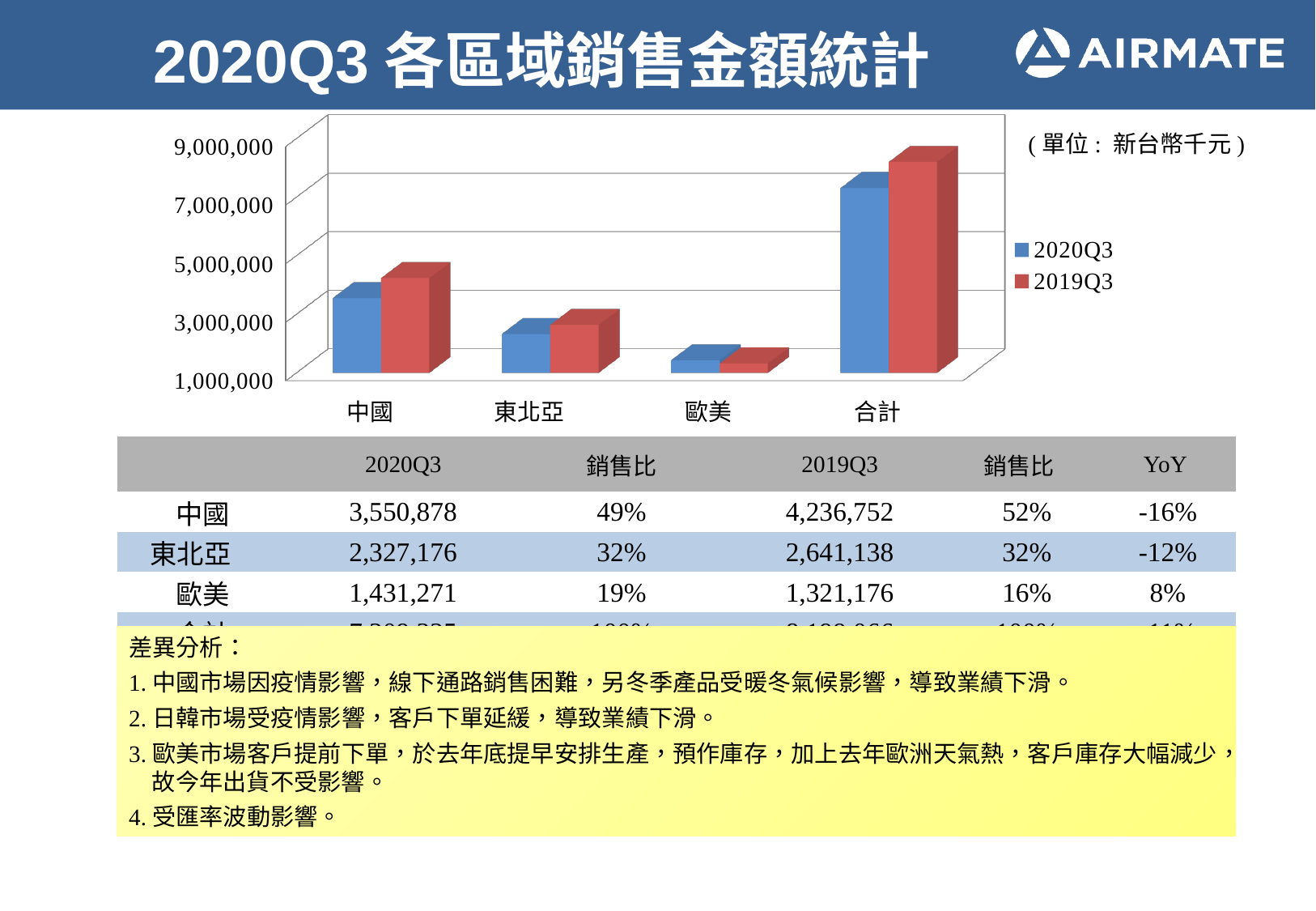
Which category has the tallest bars in the chart? 合計 What is the 2020Q3 value for 東北亞 as printed in the table below the chart? 2,327,176 What kind of chart is shown on the slide? bar chart How many series does the chart legend list? 2 For 中國, which series has the larger value, 2020Q3 or 2019Q3? 2019Q3 Which colour represents the 2019Q3 series in the chart legend? red Is the 2019Q3 value for 合計 greater or less than 7,000,000? greater How many categories are shown along the x axis of the chart? 4 What is the difference between the 2019Q3 and 2020Q3 values for 中國, using the values printed in the table? 685,874 Is the 2019Q3 value for 東北亞 greater or less than 3,000,000? less Which category has the shortest bars in the chart? 歐美 Is the 2020Q3 value for 中國 greater or less than 3,000,000? greater